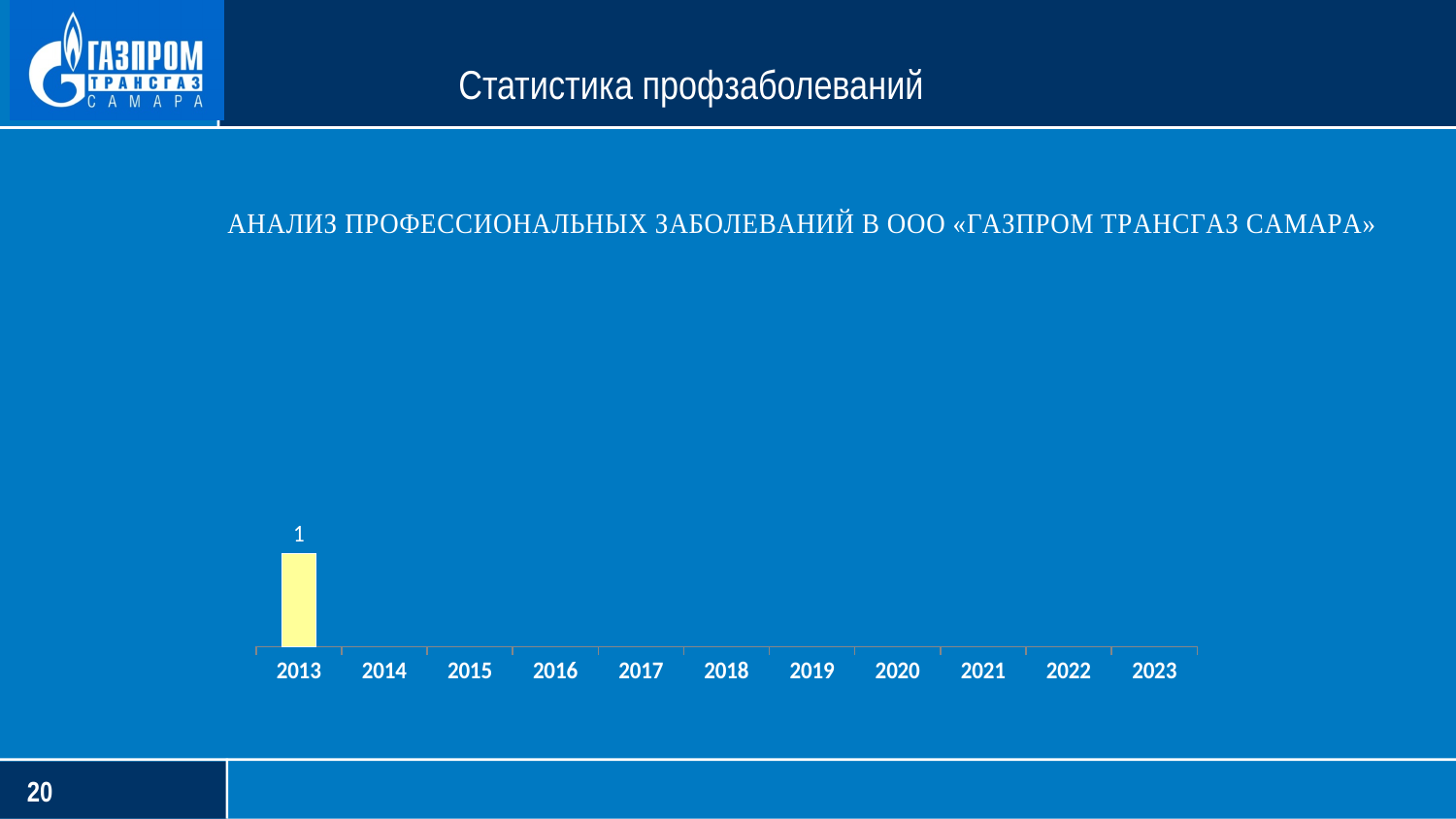
Which year has the highest value on the chart? 2013 Which is larger, the value for 2013 or the value for 2014? 2013 What kind of chart is shown on the slide? bar chart What is the last year shown on the x axis? 2023 Which is larger, the value for 2013 or the value for 2023? 2013 What is the first year shown on the x axis? 2013 What is the value shown for 2013? 1 How many years are shown on the x axis of the chart? 11